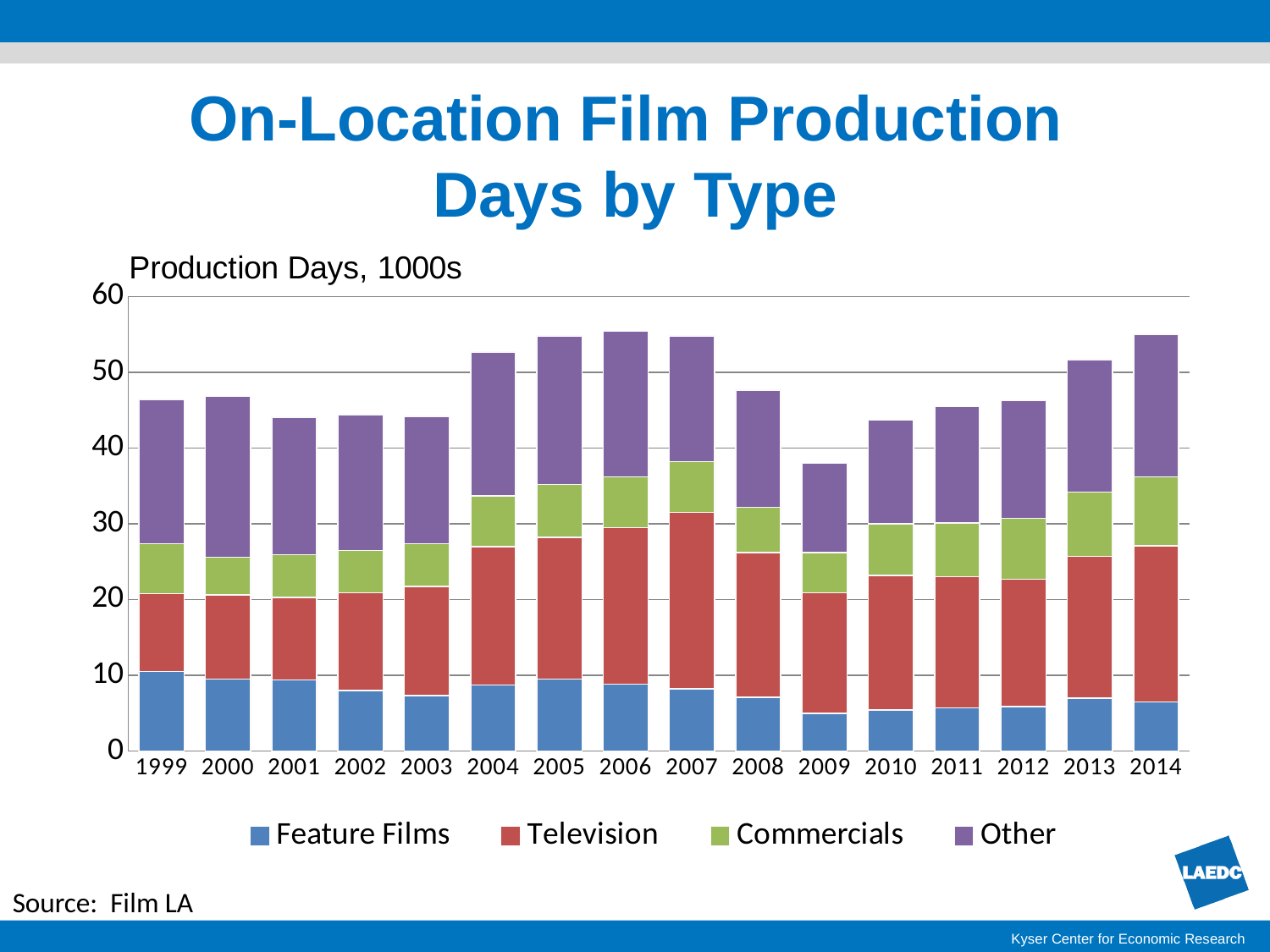
Do total production days rise or fall from 2009 to 2014? rise What is the axis title shown above the chart? Production Days, 1000s Is the total for 2006 greater or less than 50? greater Is the Feature Films value for 2009 greater or less than 10? less Which year has the larger total production days, 2006 or 2009? 2006 What kind of chart is shown on the slide? Stacked bar chart How many years are shown along the x axis? 16 Is the total for 2009 greater or less than 40? less Which colour represents Television in the legend? Red Which year has the lowest total production days? 2009 How many series does the legend list? 4